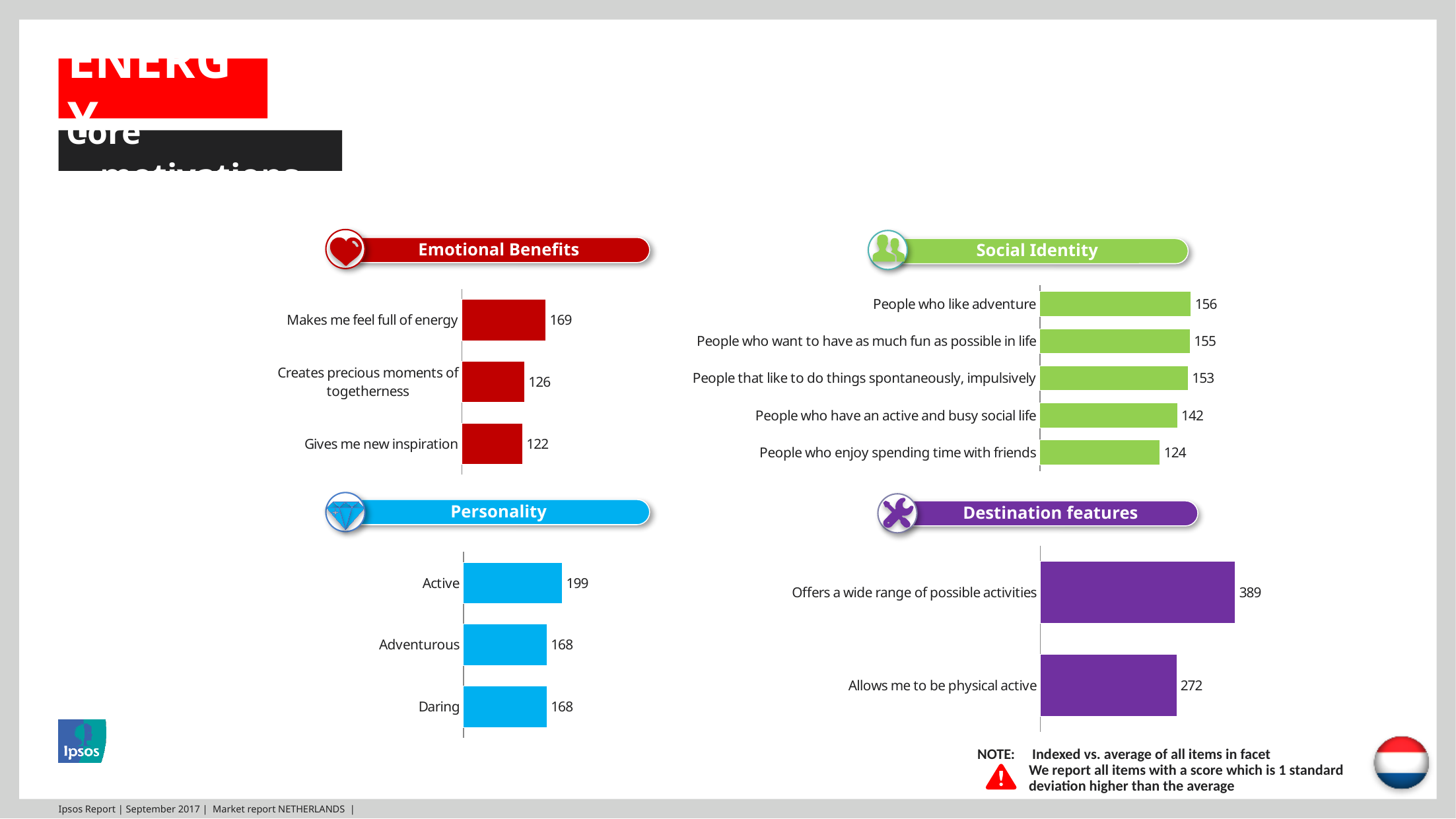
In the Destination features chart, what is the difference between "Offers a wide range of possible activities" and "Allows me to be physical active"? 117 In the Personality chart, what is the value for "Active"? 199 In the Social Identity chart, what is the difference between "People who like adventure" and "People who enjoy spending time with friends"? 32 In the Emotional Benefits chart, which category has the lowest value? Gives me new inspiration How many categories are shown in the Social Identity chart? 5 In the Emotional Benefits chart, what is the difference between "Makes me feel full of energy" and "Creates precious moments of togetherness"? 43 In the Social Identity chart, which category has the highest value? People who like adventure In the Social Identity chart, what is the value for "People who have an active and busy social life"? 142 In the Destination features chart, what is the value for "Allows me to be physical active"? 272 In the Emotional Benefits chart, what is the value for "Makes me feel full of energy"? 169 What kind of chart is the Destination features chart? Bar chart In the Personality chart, which is larger, the value for "Active" or the value for "Adventurous"? Active